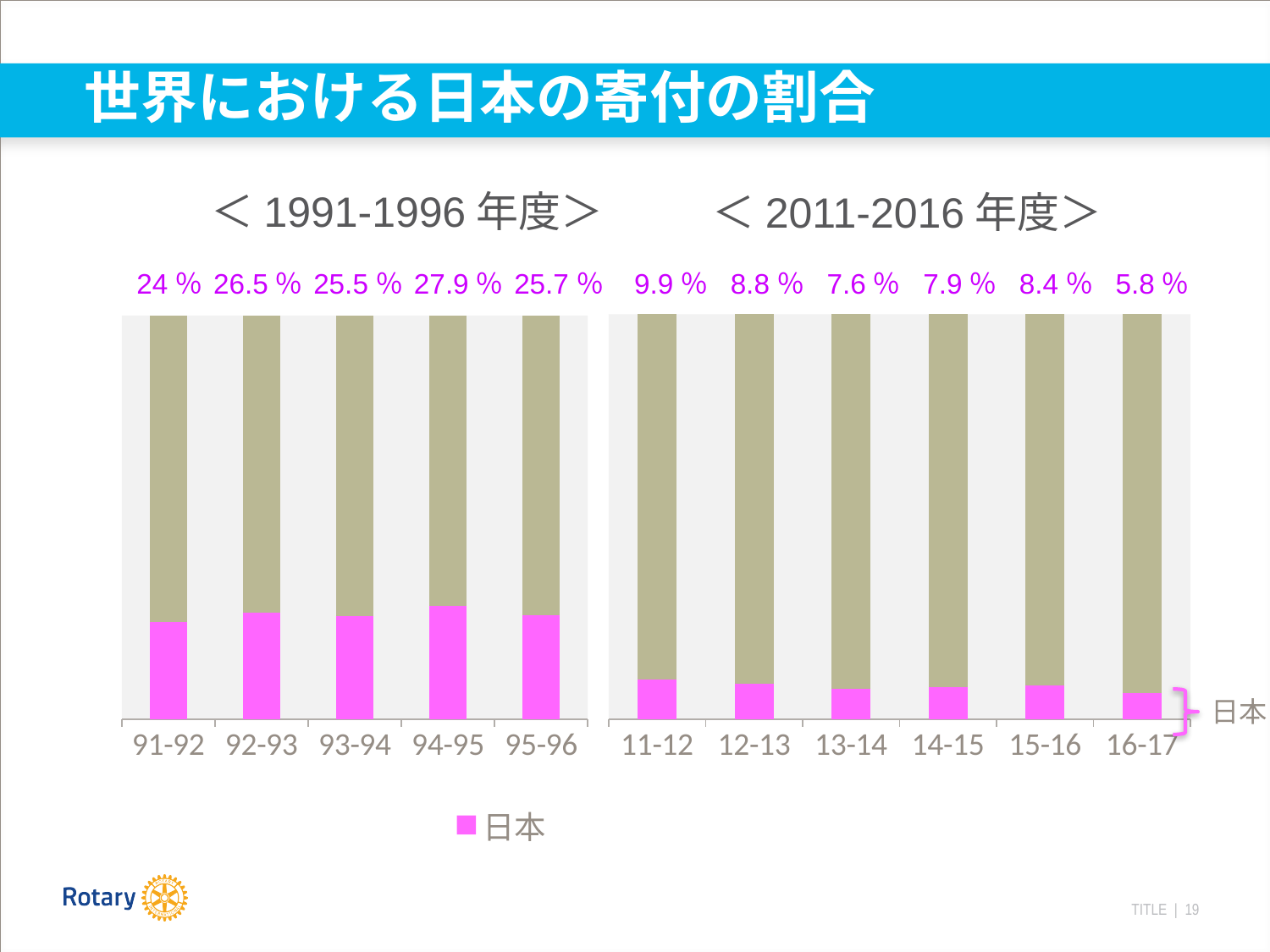
In the 2011-2016 年度 chart, which is larger, the value for 12-13 or the value for 15-16? 12-13 How many years are shown in the 1991-1996 年度 chart? 5 In the 1991-1996 年度 chart, what is the difference between the values for 94-95 and 91-92? 3.9 % In the 2011-2016 年度 chart, which year has the highest value? 11-12 In the 2011-2016 年度 chart, what is the difference between the values for 11-12 and 16-17? 4.1 % What series name does the legend below the charts show? 日本 In the 2011-2016 年度 chart, what is the value for 13-14? 7.6 % How many years are shown in the 2011-2016 年度 chart? 6 What kind of chart is the 2011-2016 年度 chart? bar chart In the 1991-1996 年度 chart, what is the value for 94-95? 27.9 % In the 1991-1996 年度 chart, which year has the highest value? 94-95 In the 2011-2016 年度 chart, which year has the lowest value? 16-17